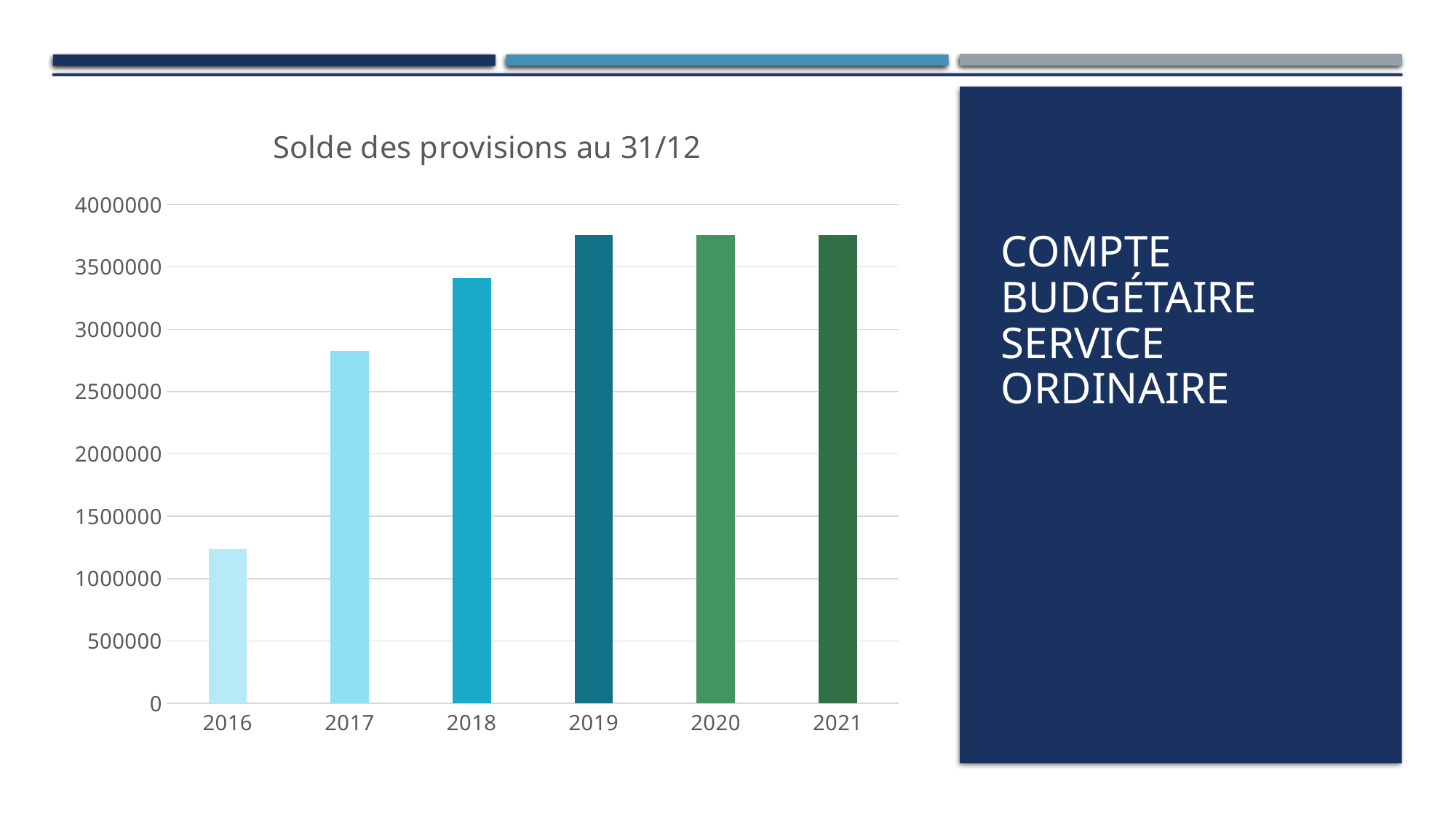
Do the values generally rise or fall from 2016 to 2021? rise What is the title of the chart? Solde des provisions au 31/12 What kind of chart is shown on the slide? bar chart How many years are shown on the x axis of the chart? 6 Which is larger, the value for 2017 or the value for 2018? 2018 Is the value for 2017 greater or less than 2500000? greater Which year has the lowest value in the chart? 2016 Is the value for 2017 greater or less than 3000000? less Is the value for 2019 greater or less than 3500000? greater